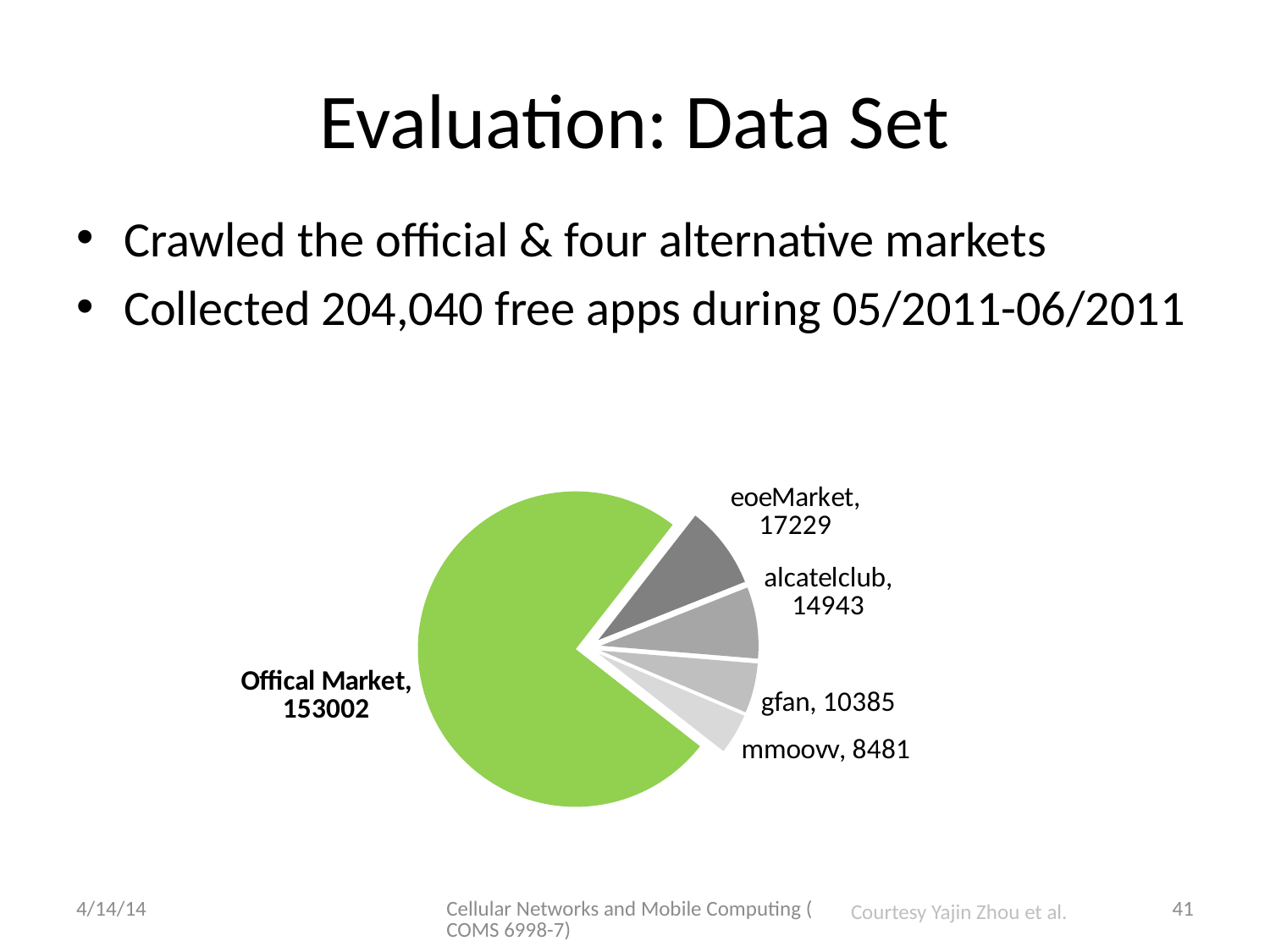
What is the value for the Offical Market slice? 153002 What is the value for eoeMarket? 17229 What is the value for alcatelclub? 14943 Which is larger, gfan or mmoovv? gfan How many slices does the pie chart have? 5 What type of chart is shown on the slide? pie chart What share of the pie does the Offical Market slice represent? 75.0% What is the total of all slices in the pie chart? 204040 Which market has the largest slice? Offical Market What is the difference between the eoeMarket and alcatelclub values? 2286 Which market has the smallest slice? mmoovv What is the value for gfan? 10385